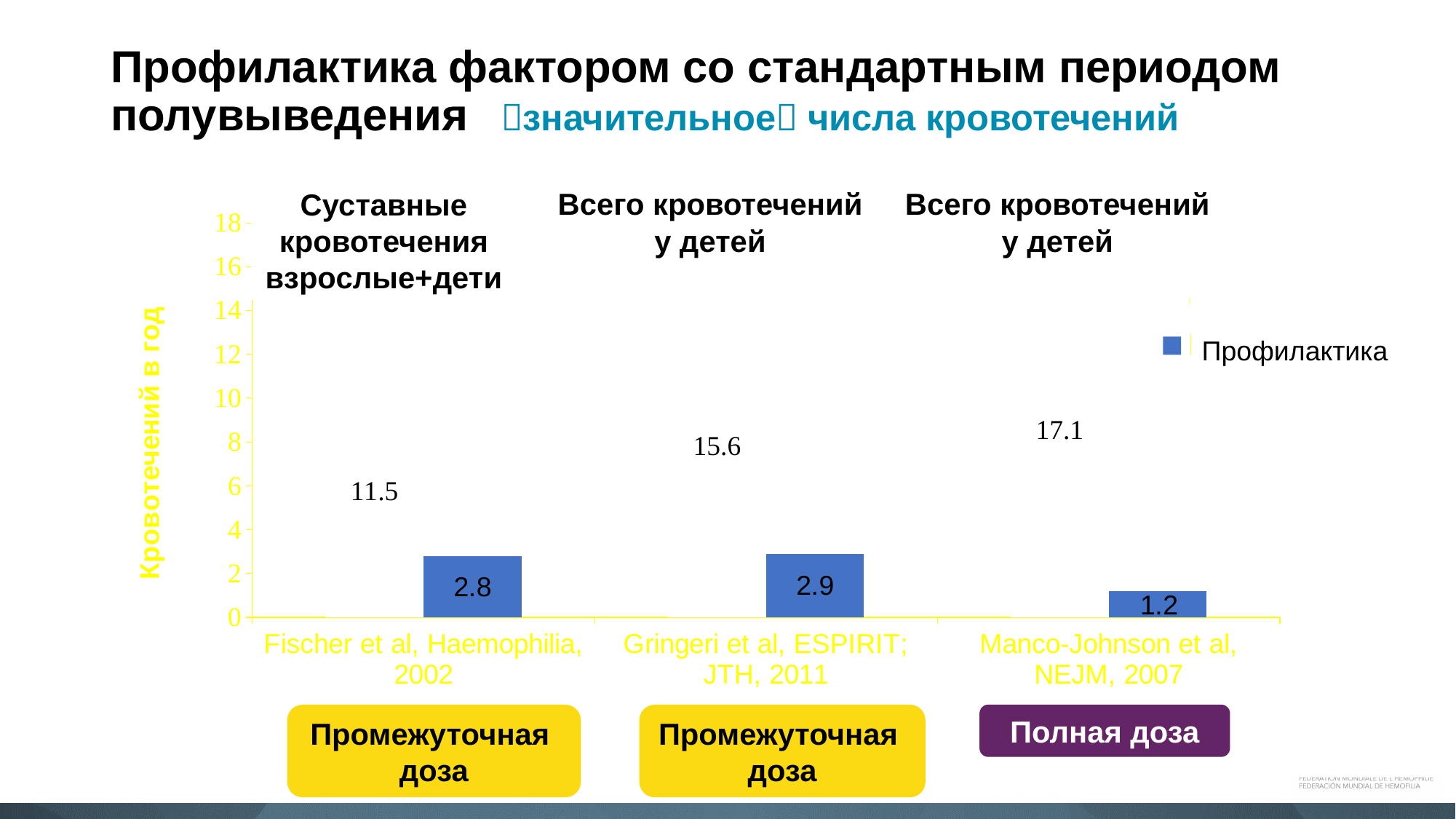
What is the label of the vertical axis of the chart? Кровотечений в год What kind of chart is shown on the slide? bar chart What is the value of the Профилактика bar for Manco-Johnson et al, NEJM, 2007? 1.2 How many studies (categories) are shown on the x axis of the chart? 3 Which study has the lowest Профилактика bar? Manco-Johnson et al, NEJM, 2007 What is the value of the Профилактика bar for Gringeri et al, ESPIRIT; JTH, 2011? 2.9 Is the Профилактика value for Gringeri et al, ESPIRIT; JTH, 2011 greater or less than 4? less What is the difference between the Профилактика values for Fischer et al, Haemophilia, 2002 and Manco-Johnson et al, NEJM, 2007? 1.6 How many series does the chart legend list? 1 What is the difference between the Профилактика values for Gringeri et al, ESPIRIT; JTH, 2011 and Manco-Johnson et al, NEJM, 2007? 1.7 Which is larger: the Профилактика bar for Fischer et al, Haemophilia, 2002 or for Manco-Johnson et al, NEJM, 2007? Fischer et al, Haemophilia, 2002 What is the value of the Профилактика bar for Fischer et al, Haemophilia, 2002? 2.8